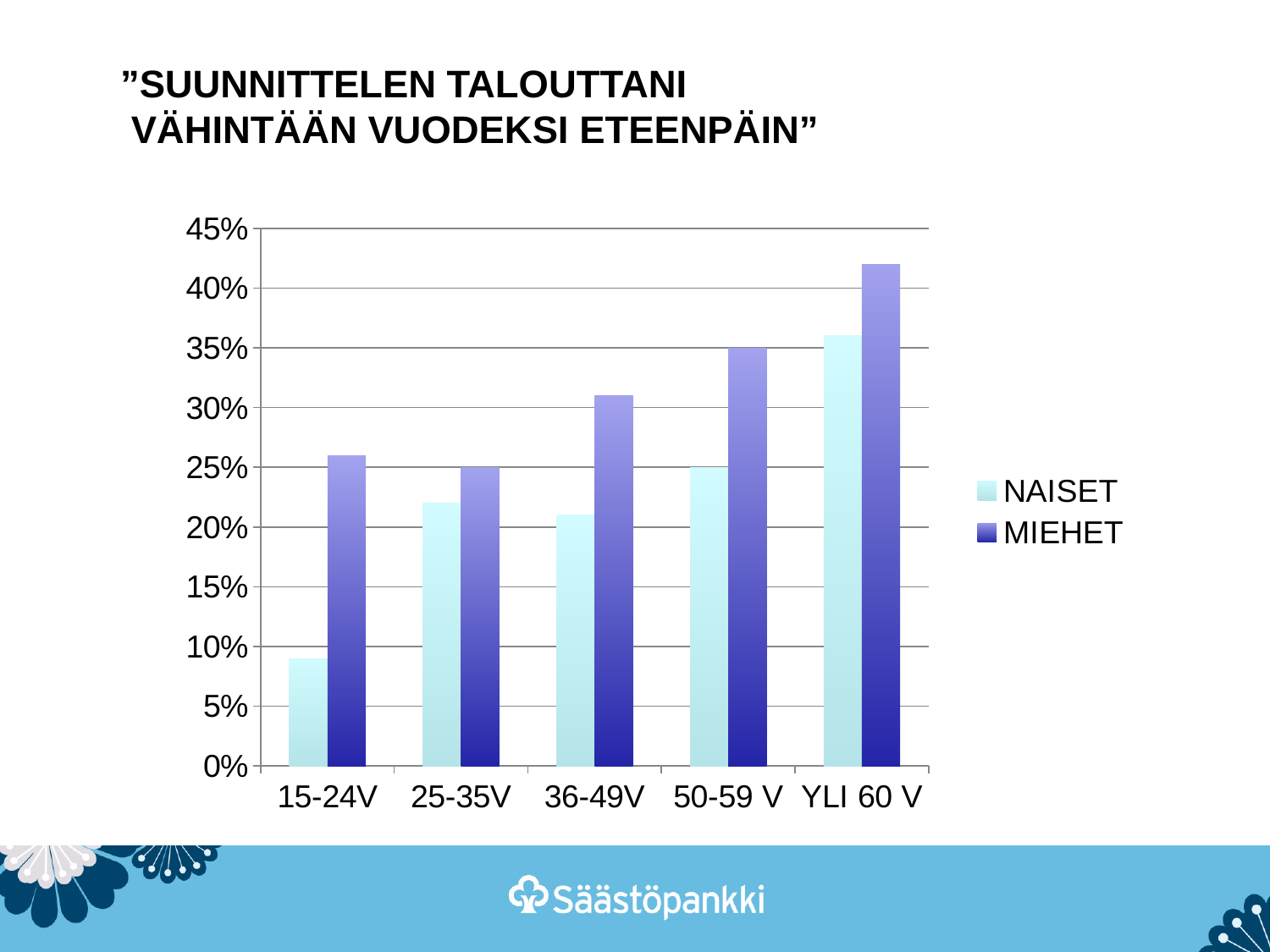
Do the MIEHET values generally rise or fall from the 15-24V category to the YLI 60 V category? rise Which is larger in the 15-24V category, NAISET or MIEHET? MIEHET Which age category has the lowest value for NAISET? 15-24V What kind of chart is shown on the slide? bar chart How many series does the legend list? 2 Is the value for NAISET in the 15-24V category greater or less than 10%? less Which series is shown in light blue in the legend? NAISET Is the value for MIEHET in the YLI 60 V category greater or less than 40%? greater Which age category has the highest value for MIEHET? YLI 60 V How many age categories are shown on the x axis? 5 Is the value for NAISET in the YLI 60 V category greater or less than 35%? greater